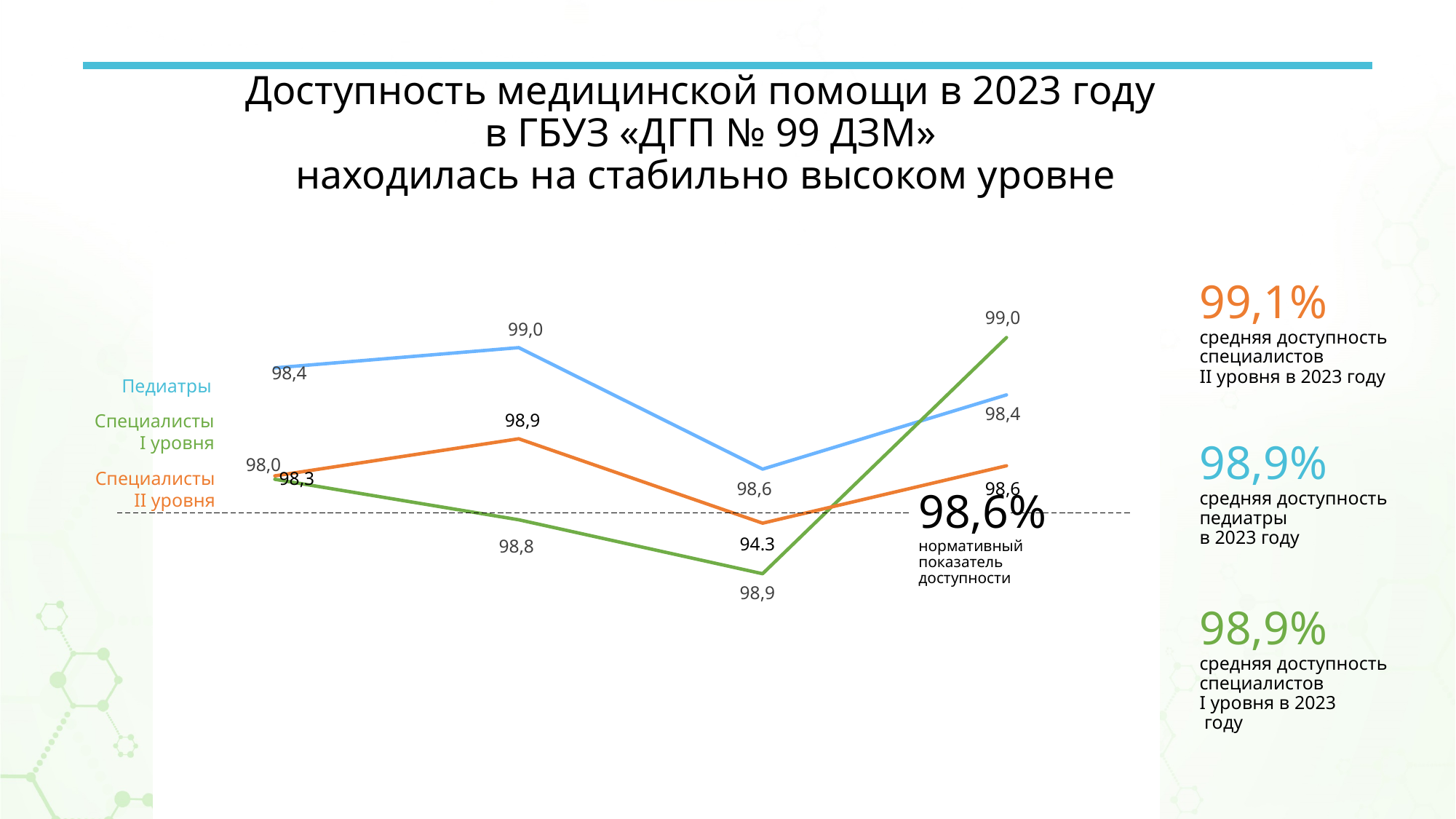
At the last point, which series has the highest value? Специалисты I уровня At the first point, which is higher: Педиатры or Специалисты II уровня? Педиатры What is the value of the second point on the Педиатры line? 99,0 What is the difference between the second point (99,0) and the first point (98,4) on the Педиатры line? 0,6 What kind of chart is shown on the slide? line chart What is the lowest value on the Специалисты II уровня line? 94.3 What is the value of the first point on the Специалисты II уровня line? 98,0 What is the highest value on the Педиатры line? 99,0 What is the value of the last point on the Специалисты I уровня line? 99,0 How many series are plotted on the chart? 3 How many data points does the Педиатры line have? 4 What value does the dashed horizontal line (нормативный показатель доступности) represent? 98,6%